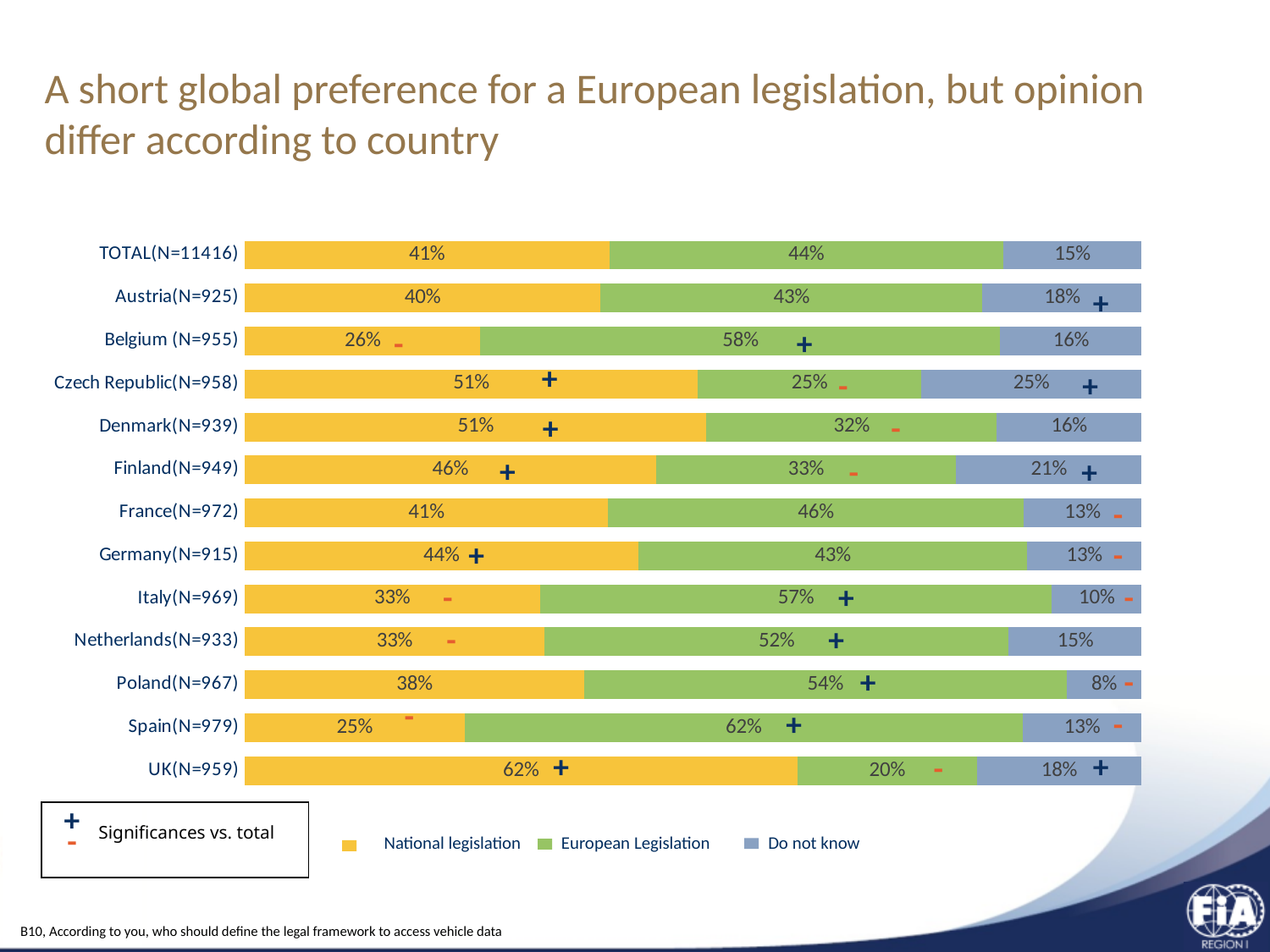
What is the European Legislation value for the TOTAL row? 44% Which is larger for Germany: National legislation or European Legislation? National legislation What is the National legislation value for the UK? 62% What is the total of the stacked bar for Spain? 100% What is the Do not know value for the Czech Republic? 25% How many categories (rows) are shown in the chart? 13 How many series does the legend list? 3 What is the difference between the European Legislation values for Spain and the UK? 42% Which country has the lowest Do not know value? Poland What percentage of respondents in Belgium prefer European Legislation? 58% What kind of chart is shown on the slide? Stacked bar chart Which country has the highest European Legislation value? Spain